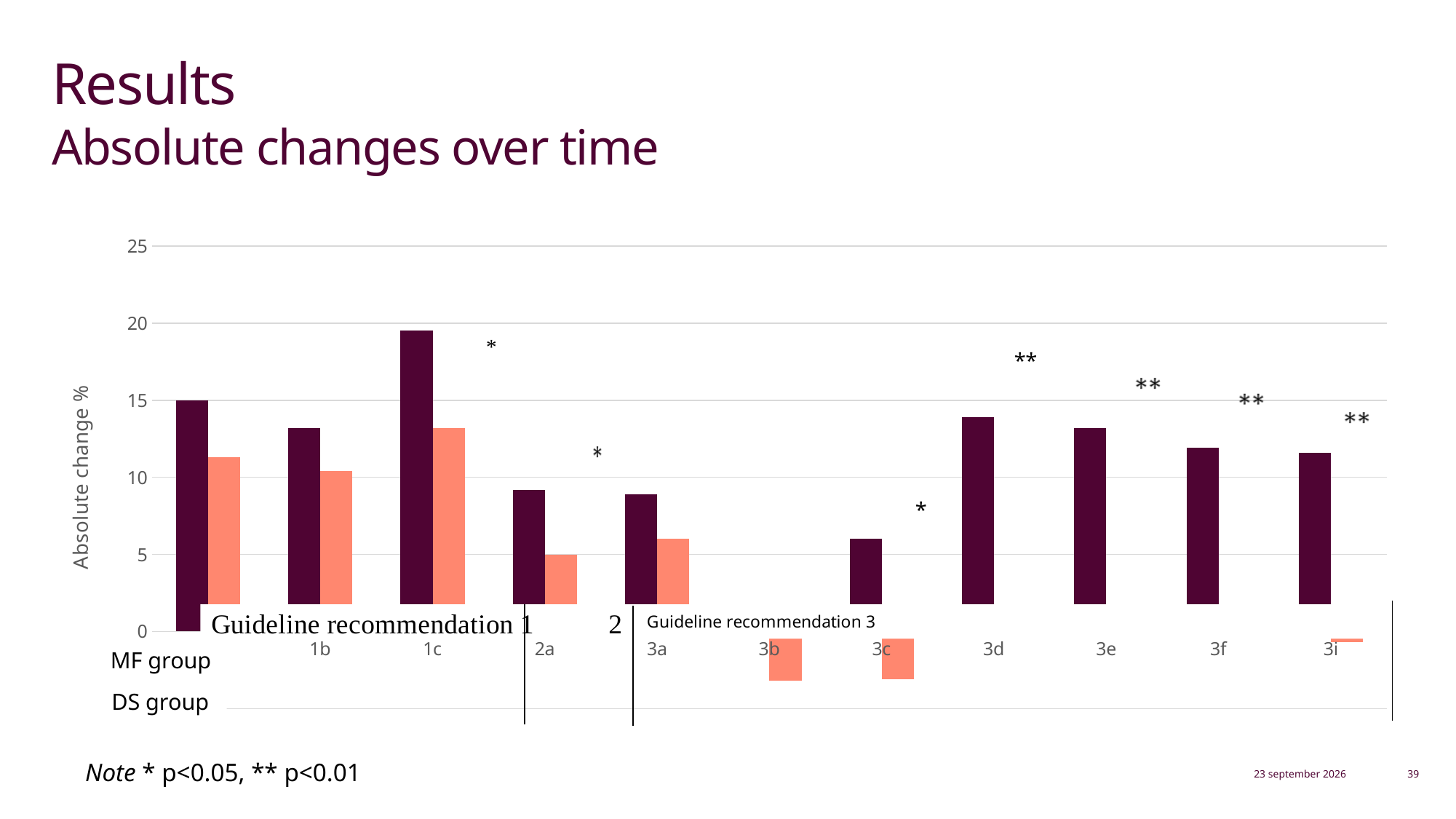
Which is larger, the DS group value for 1c or the DS group value for 3a? 1c Is the DS group value for 1b greater or less than 5? greater Which category has the highest MF group bar? 1c Is the MF group value for 3d greater or less than 10? greater How many series does the legend list? 2 What is the label of the vertical axis? Absolute change % What kind of chart is shown on the slide? bar chart Is the MF group value for 3c greater or less than 10? less Which is larger for category 2a, the MF group bar or the DS group bar? MF group Do the MF group values rise or fall from 3d to 3i? fall